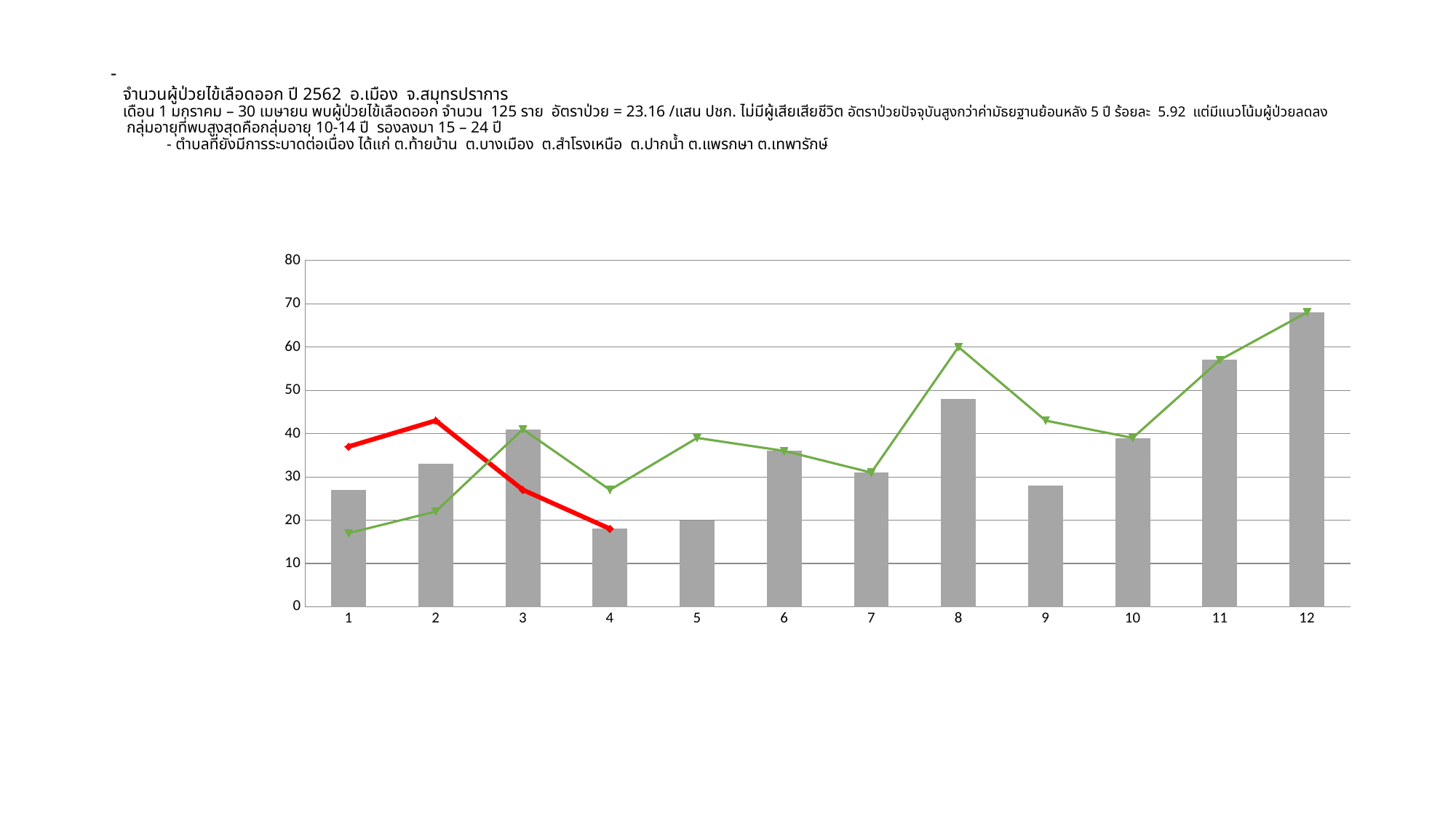
Is the green line value at category 1 greater or less than 20? less Do the bars rise or fall from category 9 to category 12? rise Which bar is taller, category 3 or category 2? 3 Is the bar value for category 12 greater or less than 60? greater What kind of chart is shown on the slide? A bar chart combined with line series Which category has the tallest bar in the chart? 12 Is the bar value for category 8 greater or less than 40? greater Which bar is taller, category 11 or category 8? 11 How many categories are shown on the x axis of the chart? 12 Does the red line rise or fall from category 2 to category 4? fall